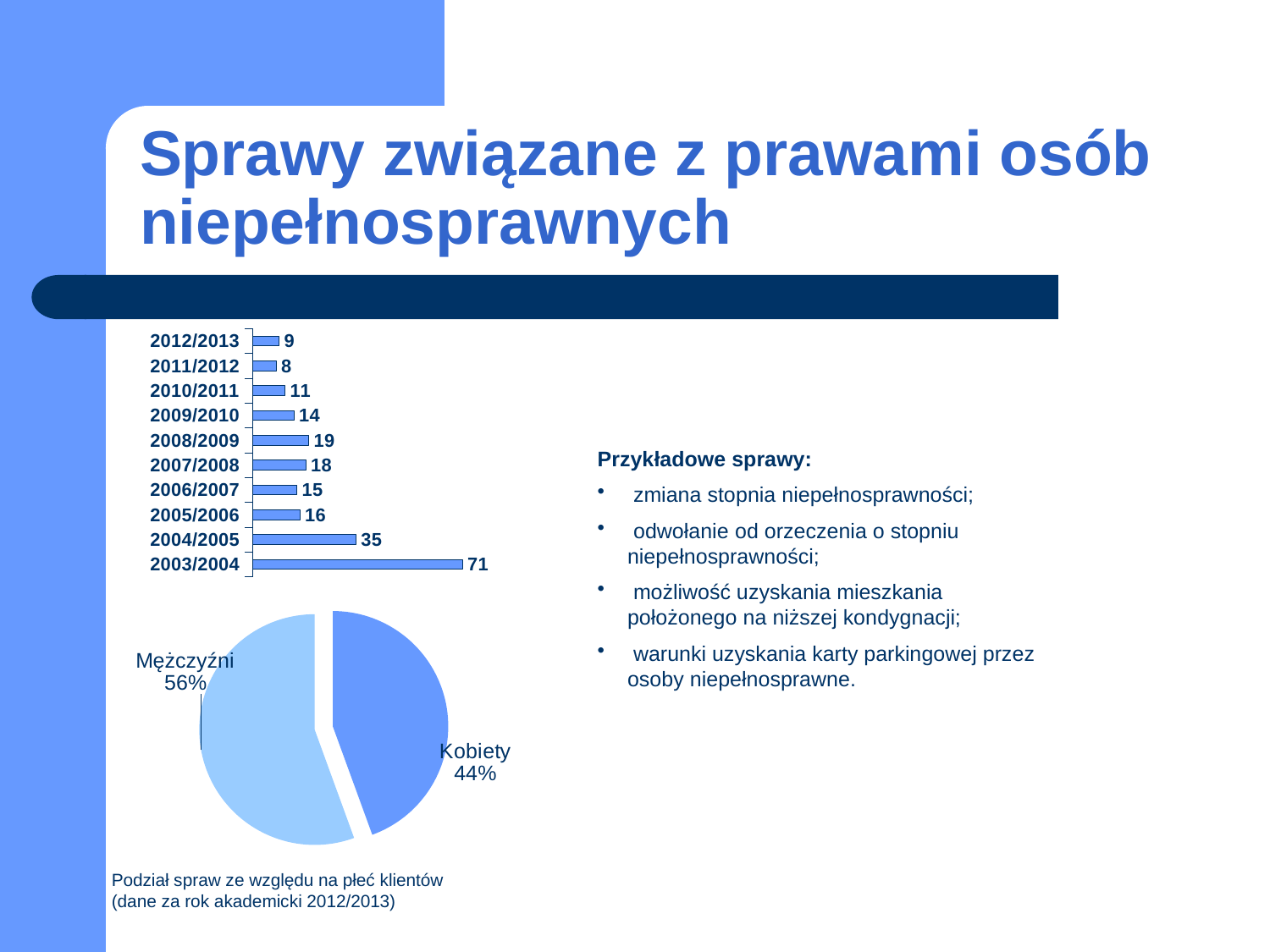
In the bar chart at the top left, which is larger, the value for 2005/2006 or the value for 2006/2007? 2005/2006 In the pie chart at the bottom left, which slice is larger, Mężczyźni or Kobiety? Mężczyźni In the bar chart at the top left, which academic year has the lowest value? 2011/2012 In the bar chart at the top left, what is the difference between the values for 2003/2004 and 2004/2005? 36 What kind of chart is the chart at the top left of the slide? bar chart In the bar chart at the top left, which academic year has the highest value? 2003/2004 In the bar chart at the top left, what is the value for 2003/2004? 71 In the bar chart at the top left, what is the value for 2008/2009? 19 How many academic years are shown in the bar chart at the top left? 10 What kind of chart is the chart at the bottom left of the slide? pie chart In the pie chart at the bottom left, what share is labelled Kobiety? 44% In the bar chart at the top left, what is the value for 2012/2013? 9